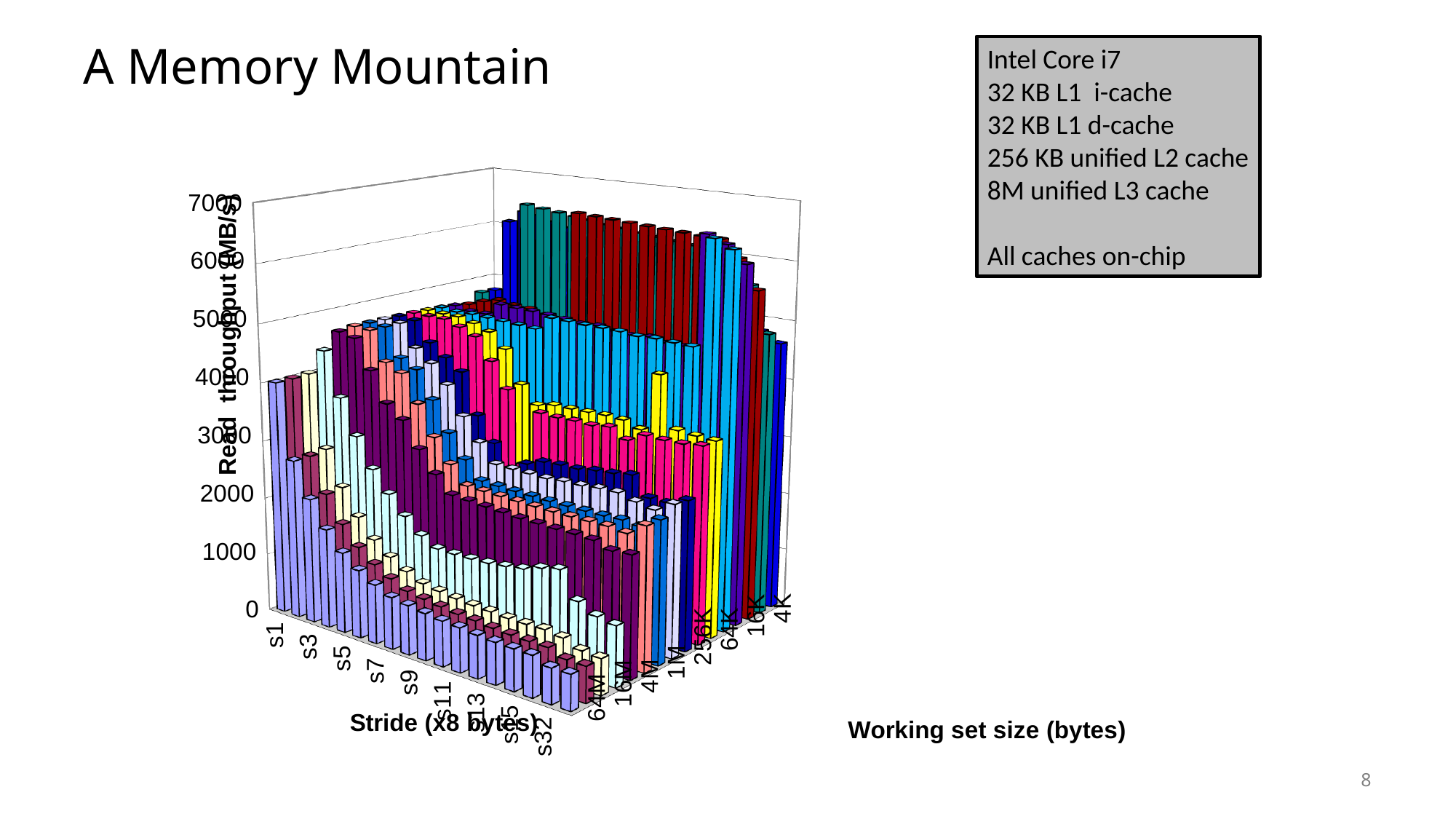
Is the read throughput for stride s1 at working set size 64M greater or less than 3000? greater How many stride labels are shown along the front axis? 9 How many working set size labels are shown along the depth axis? 8 What kind of chart is shown on the slide? 3D bar chart What is the highest tick value shown on the vertical axis? 7000 Along the stride axis at working set size 64M, does read throughput rise or fall as stride increases from s1 to s32? fall What is the label of the vertical axis of the chart? Read throughput (MB/s) Which working set size has the tallest bars in the chart, 4K or 64M? 4K Which stride has the higher read throughput at working set size 64M, s1 or s32? s1 What is the label of the front horizontal axis of the chart? Stride (x8 bytes) Is the read throughput for stride s32 at working set size 64M greater or less than 1000? less